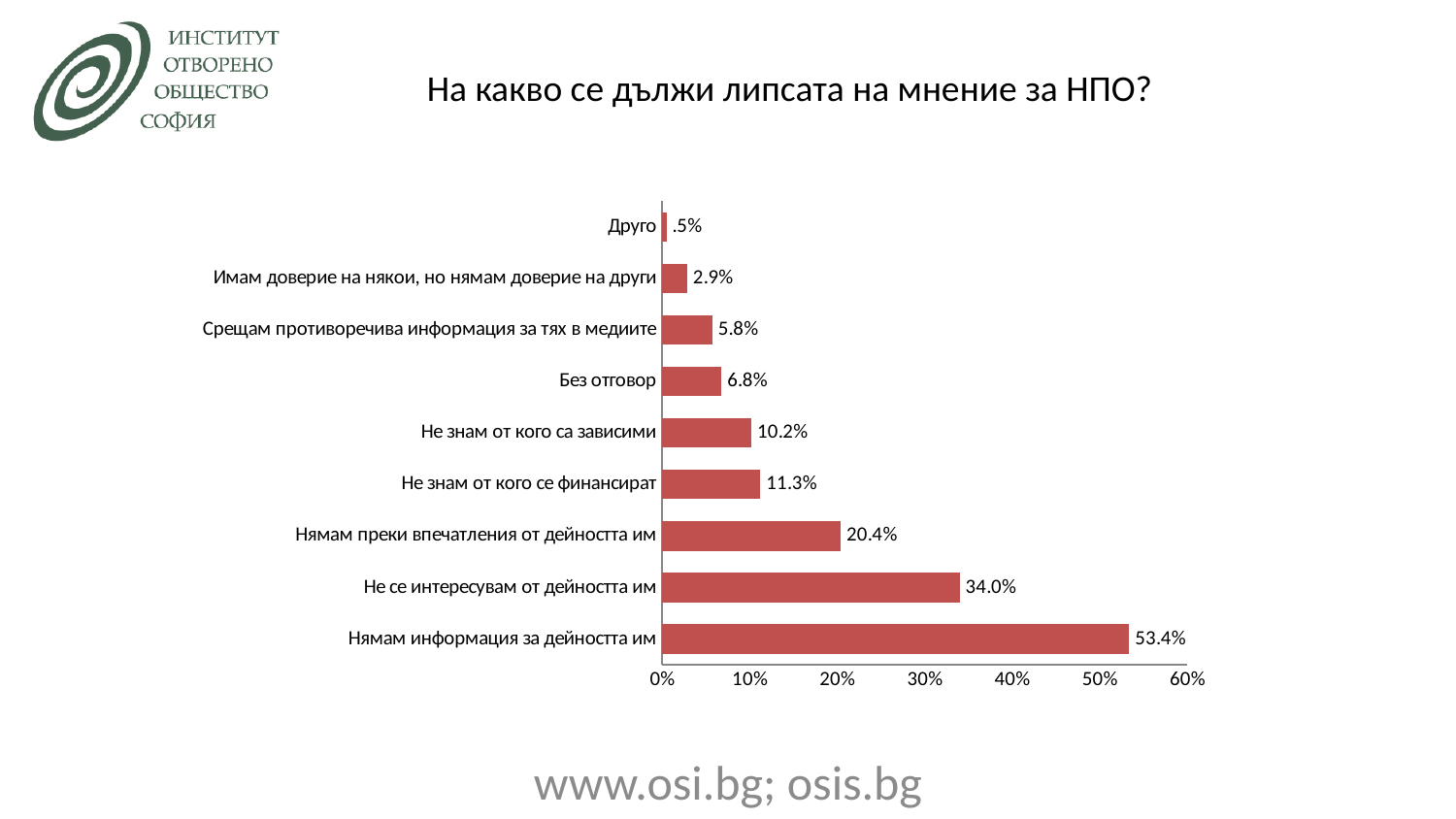
What is the value for "Не знам от кого се финансират"? 11.3% Is the value for "Нямам преки впечатления от дейността им" greater or less than 30%? less Which category has the highest value? Нямам информация за дейността им Which is larger: "Без отговор" or "Срещам противоречива информация за тях в медиите"? Без отговор What is the title of the chart? На какво се дължи липсата на мнение за НПО? How many categories are shown in the chart? 9 What is the maximum value shown on the x axis? 60% What is the value for "Нямам информация за дейността им"? 53.4% Which category has the lowest value? Друго What is the difference between "Нямам информация за дейността им" and "Не се интересувам от дейността им"? 19.4% What kind of chart is shown on the slide? bar chart What is the value for "Друго"? .5%